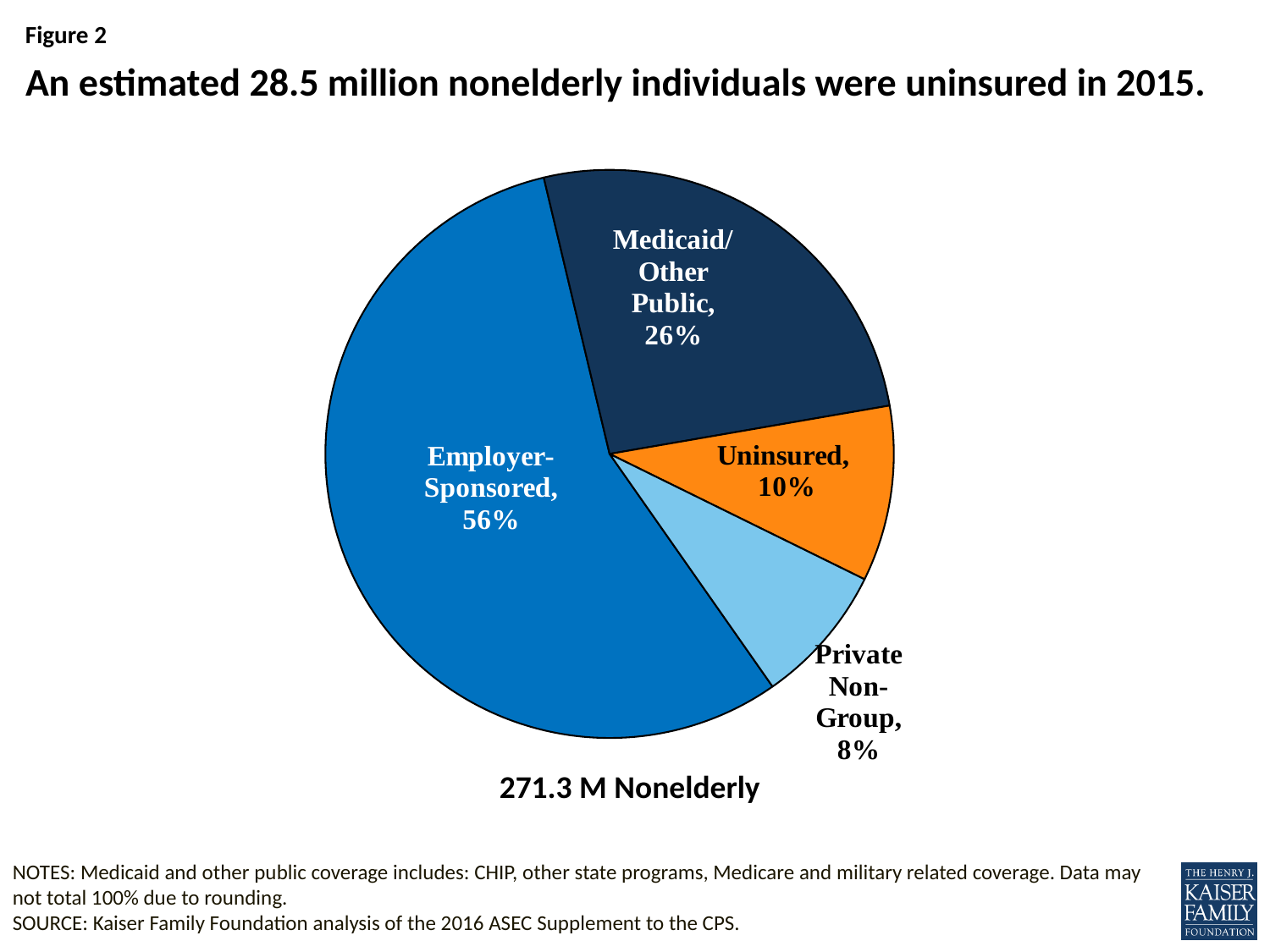
What kind of chart is shown on the slide? Pie chart What is the difference in percentage points between the Employer-Sponsored and Medicaid/Other Public slices? 30 Which category has the smallest slice of the pie? Private Non-Group What total population does the label below the pie chart give? 271.3 M Nonelderly What share of the pie is Private Non-Group coverage? 8% Which category has the largest slice of the pie? Employer-Sponsored Which is larger, the Uninsured slice or the Private Non-Group slice? Uninsured How many slices does the pie chart have? 4 What share of the pie is Employer-Sponsored coverage? 56% What colour is the Uninsured slice? Orange What share of the pie is Uninsured? 10% What share of the pie is Medicaid/Other Public coverage? 26%